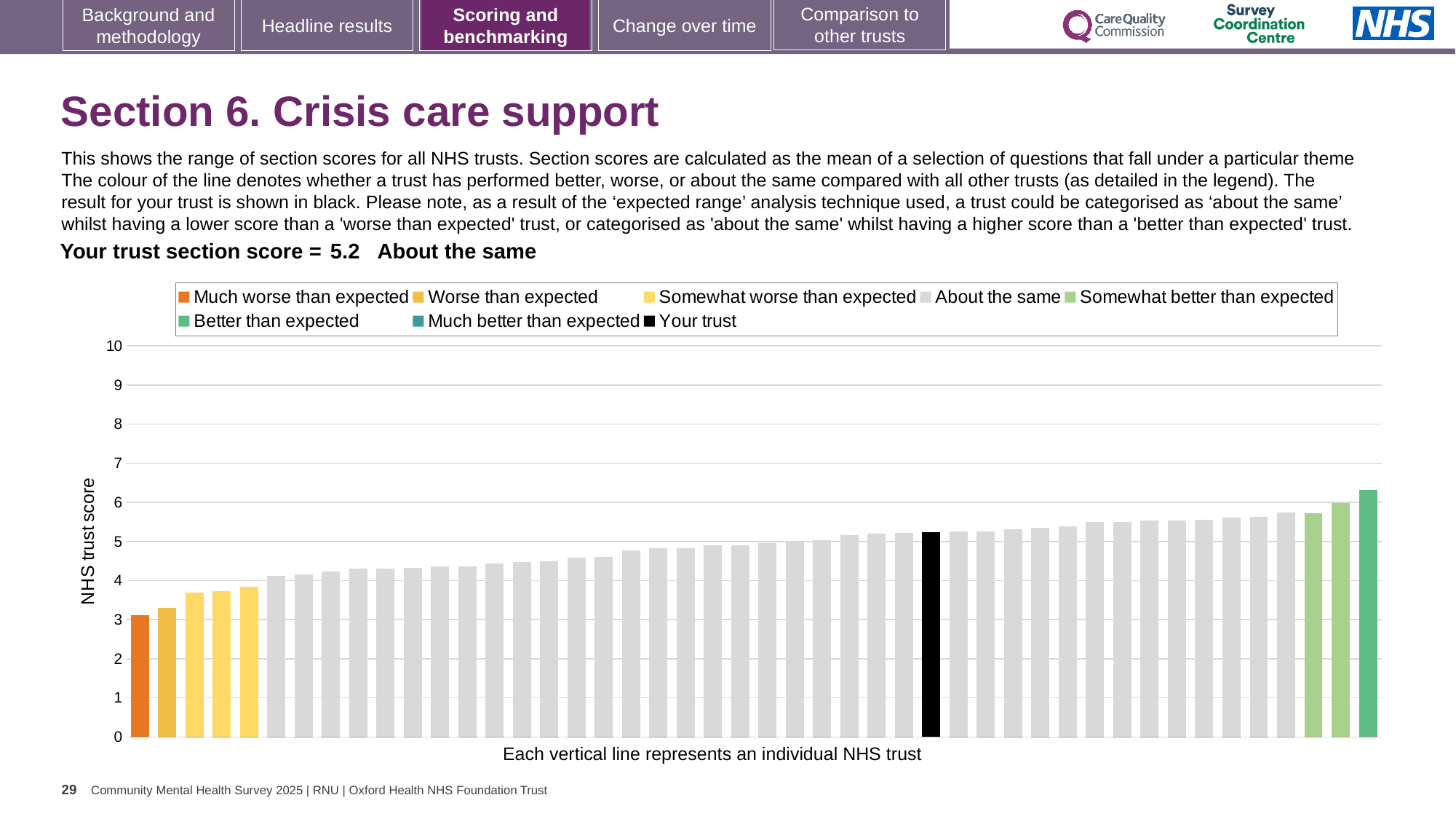
Is the value of the tallest bar greater or less than 7? less What colour is the bar representing your trust? black Is the value of the black 'Your trust' bar greater or less than 5? greater Which category is your trust placed in for this section? About the same What is the section score for your trust? 5.2 What kind of chart is shown on the slide? bar chart How many entries does the chart legend list? 8 Is the value of the shortest bar greater or less than 4? less Do the bar values rise or fall from left to right along the x axis? rise Which is taller: the leftmost orange bar or the black 'Your trust' bar? the black 'Your trust' bar What is the label on the y axis of the chart? NHS trust score